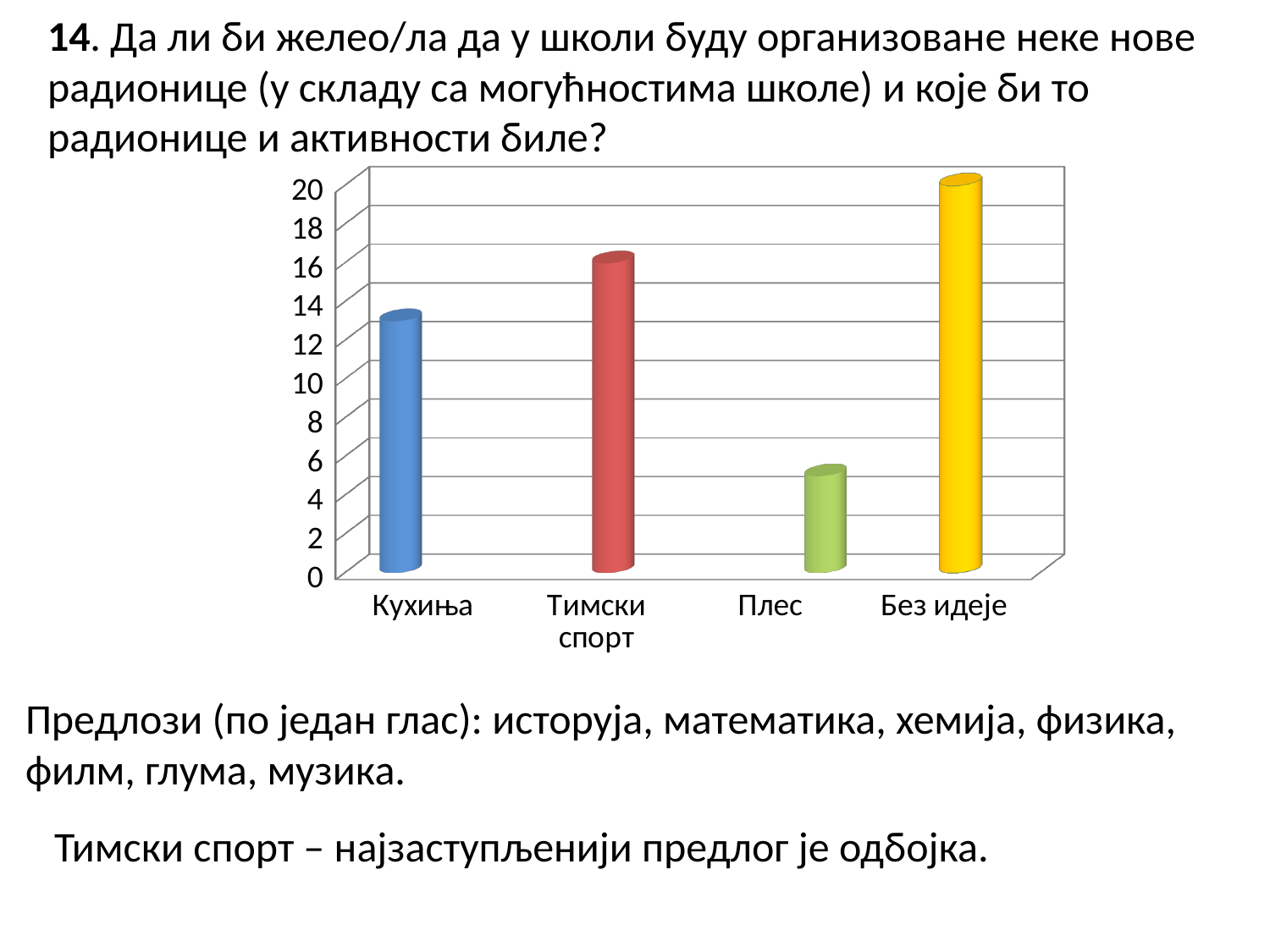
Which category has the highest bar in the chart? Без идеје Is the value for Кухиња greater or less than 10? greater What kind of chart is shown on the slide? bar chart How many categories are shown on the x axis of the chart? 4 Which is larger, the value for Тимски спорт or the value for Кухиња? Тимски спорт Is the value for Плес greater or less than 8? less Which category has the lowest bar in the chart? Плес Is the value for Тимски спорт greater or less than 14? greater Which is larger, the value for Плес or the value for Кухиња? Кухиња What colour is the bar for Без идеје? yellow What is the highest tick value shown on the vertical axis of the chart? 20